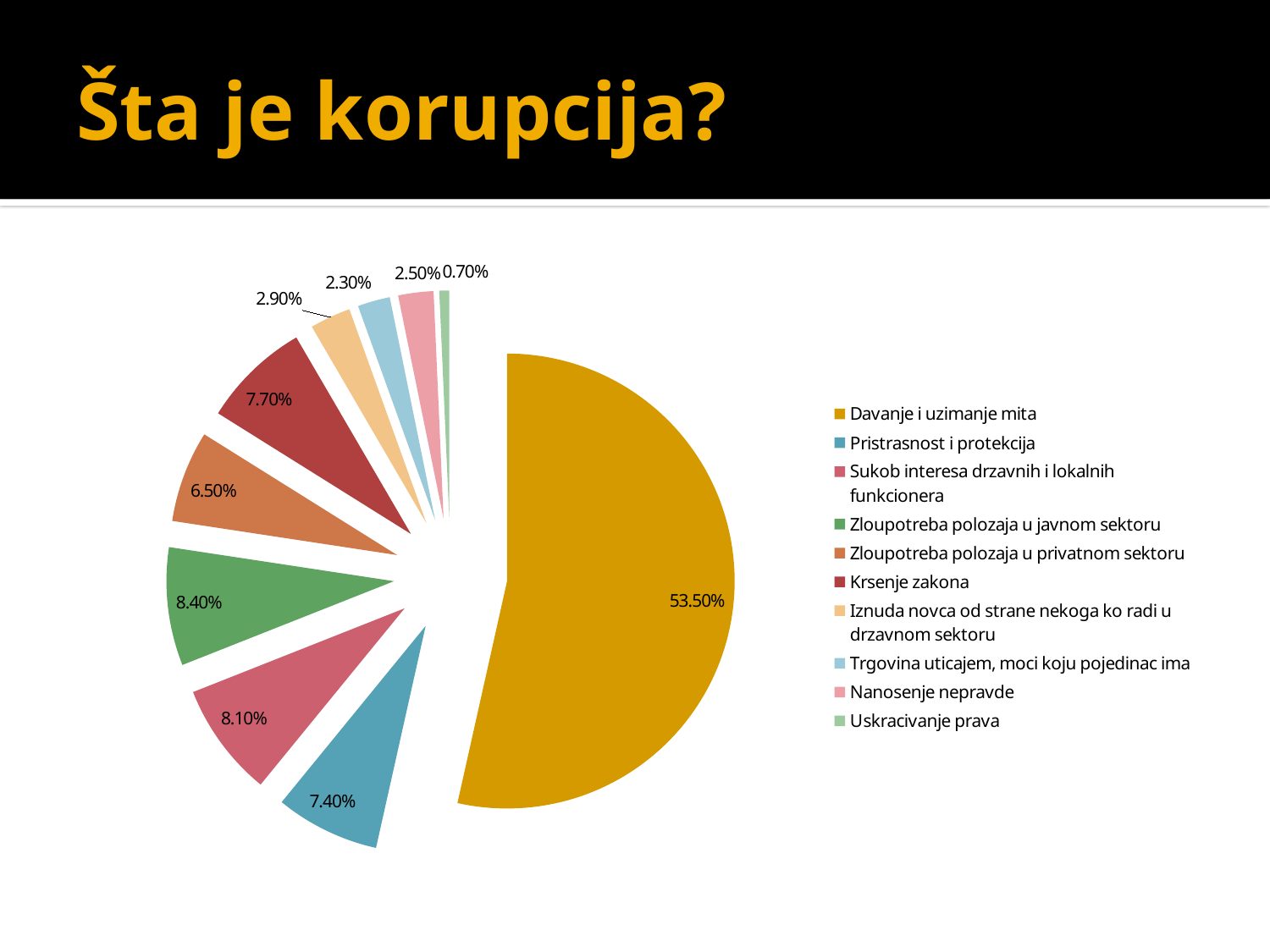
What is the value for Zloupotreba polozaja u javnom sektoru? 8.40% Which is larger, Sukob interesa drzavnih i lokalnih funkcionera or Pristrasnost i protekcija? Sukob interesa drzavnih i lokalnih funkcionera What is the value for Davanje i uzimanje mita? 53.50% What is the value for Krsenje zakona? 7.70% Which category has the largest share of the pie? Davanje i uzimanje mita What is the difference between the values for Zloupotreba polozaja u javnom sektoru and Zloupotreba polozaja u privatnom sektoru? 1.90% What kind of chart is shown on the slide? pie chart What colour is the slice for Davanje i uzimanje mita? gold What is the value for Pristrasnost i protekcija? 7.40% What is the value for Uskracivanje prava? 0.70% Which category has the smallest share of the pie? Uskracivanje prava How many categories does the legend list? 10